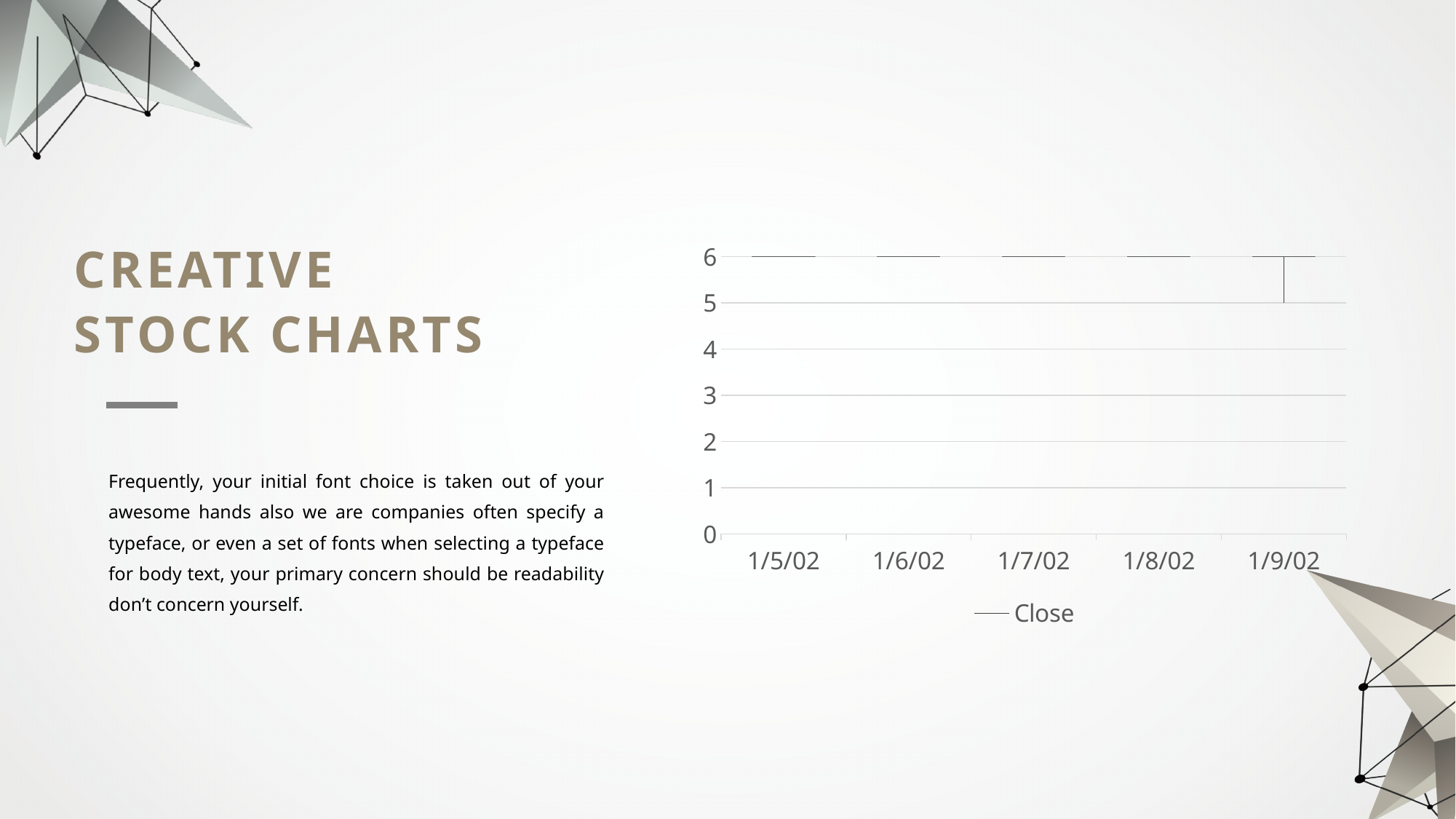
Is the Close value for 1/7/02 greater or less than 4? greater How many series does the chart legend list? 1 Which date shows a vertical high-low line extending below the Close mark? 1/9/02 What is the first date shown on the x axis of the chart? 1/5/02 What is the name of the series shown in the chart legend? Close How many dates are shown on the x axis of the chart? 5 What kind of chart is shown on the slide? stock chart Is the Close value for 1/8/02 greater or less than 2? greater Is the Close value for 1/5/02 greater or less than 3? greater